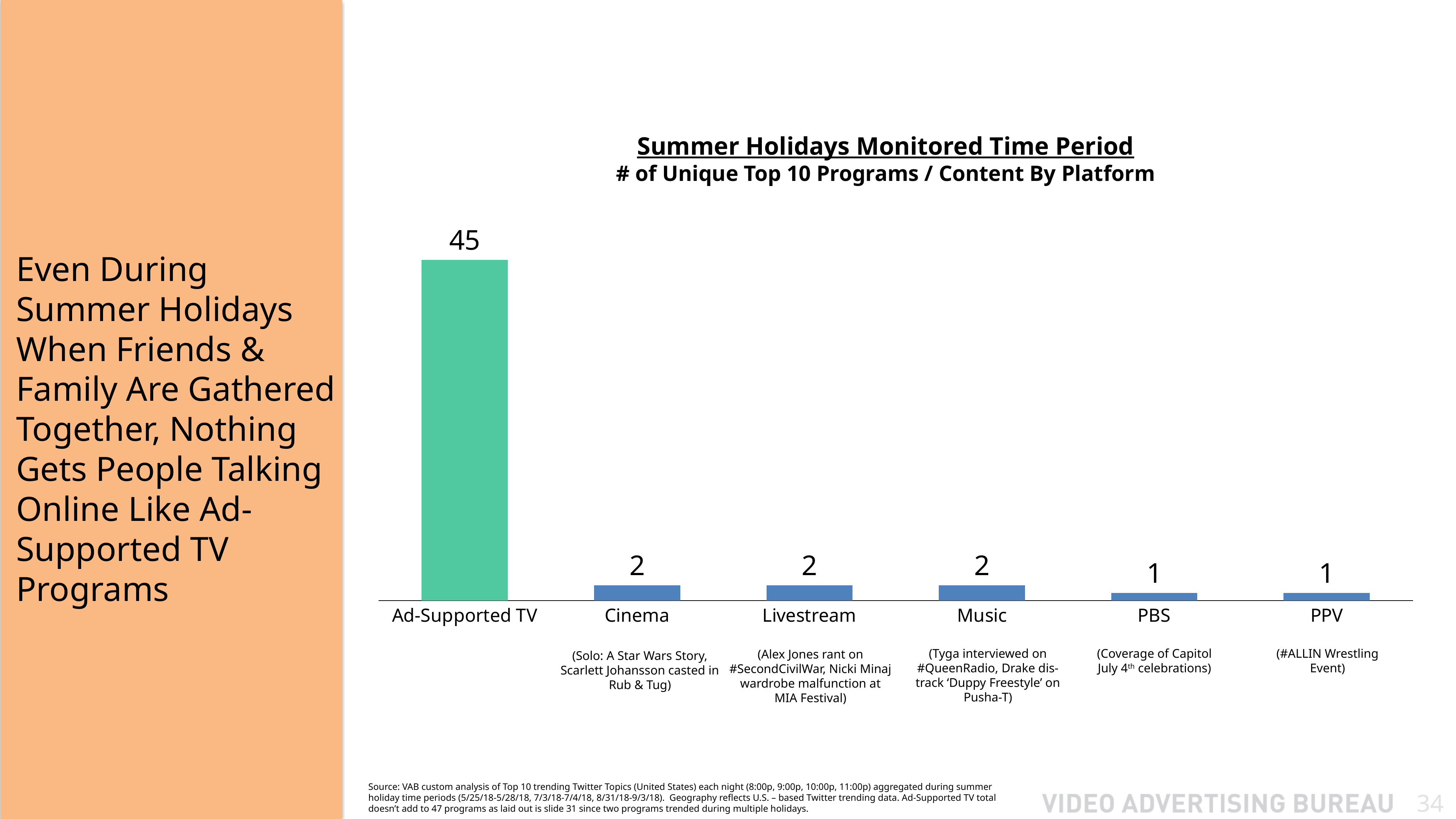
What kind of chart is shown on the slide? Bar chart What is the value for PBS? 1 Which platform has the highest number of unique Top 10 programs? Ad-Supported TV How many platforms are shown on the chart? 6 What is the value for Cinema? 2 What is the difference between the values for Livestream and PBS? 1 Which is larger, the value for Cinema or the value for PPV? Cinema What is the value for PPV? 1 What is the value for Ad-Supported TV? 45 What is the difference between the values for Ad-Supported TV and Music? 43 Which bar is coloured green rather than blue? Ad-Supported TV What is the title of the chart? Summer Holidays Monitored Time Period